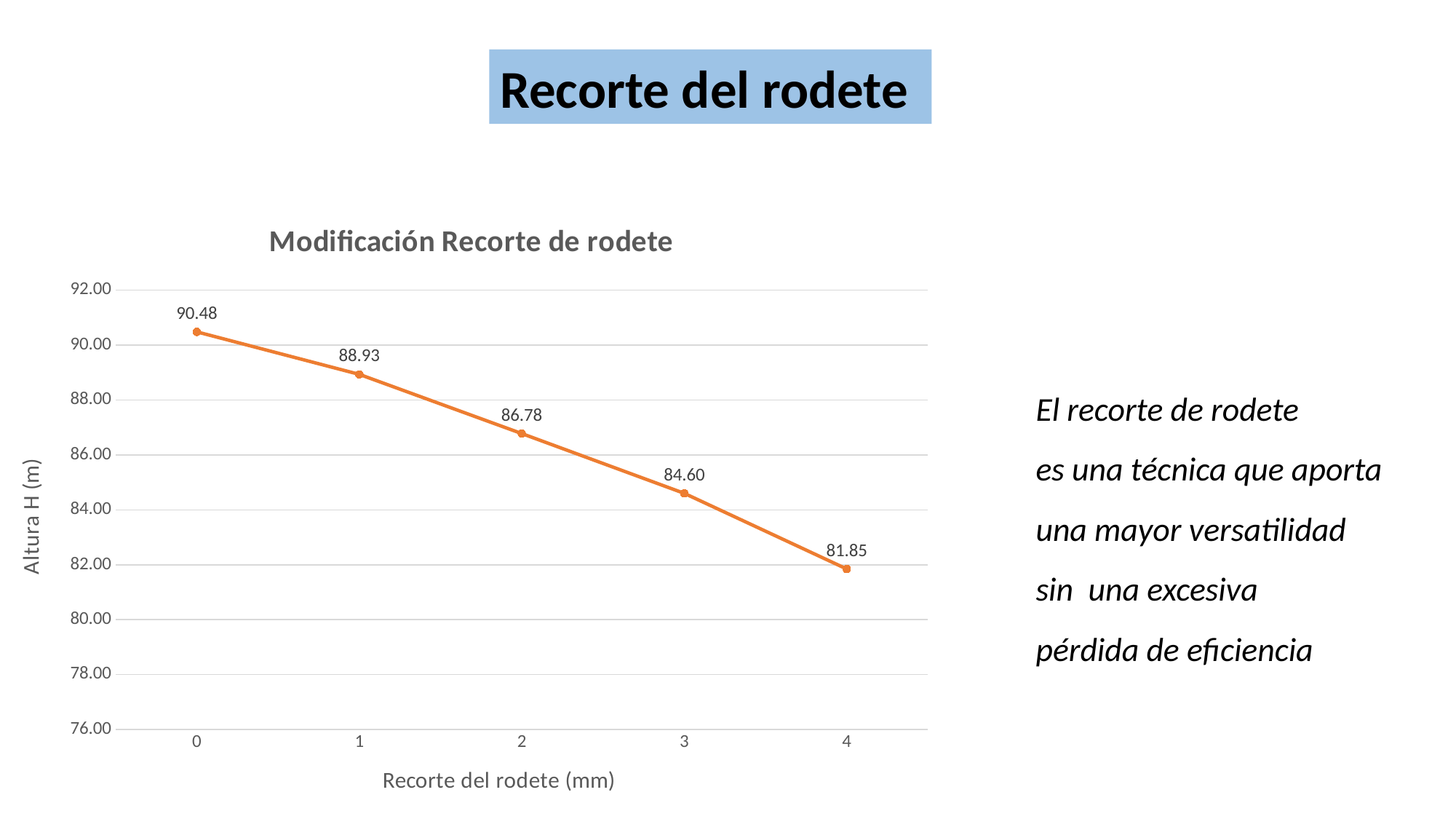
Is the value of Altura H at 3 mm greater or less than 86.00? less At which recorte del rodete value is Altura H highest? 0 What is the difference between the Altura H values at 0 mm and 4 mm? 8.63 What is the difference between the Altura H values at 1 mm and 3 mm? 4.33 Which is larger, the Altura H value at 1 mm or at 3 mm? 1 mm At which recorte del rodete value is Altura H lowest? 4 Do the Altura H values rise or fall as the recorte del rodete increases? fall What is the value of Altura H at a recorte del rodete of 0 mm? 90.48 What is the value of Altura H at a recorte del rodete of 2 mm? 86.78 How many data points are plotted on the chart? 5 What is the value of Altura H at a recorte del rodete of 4 mm? 81.85 What kind of chart is shown on the slide? line chart